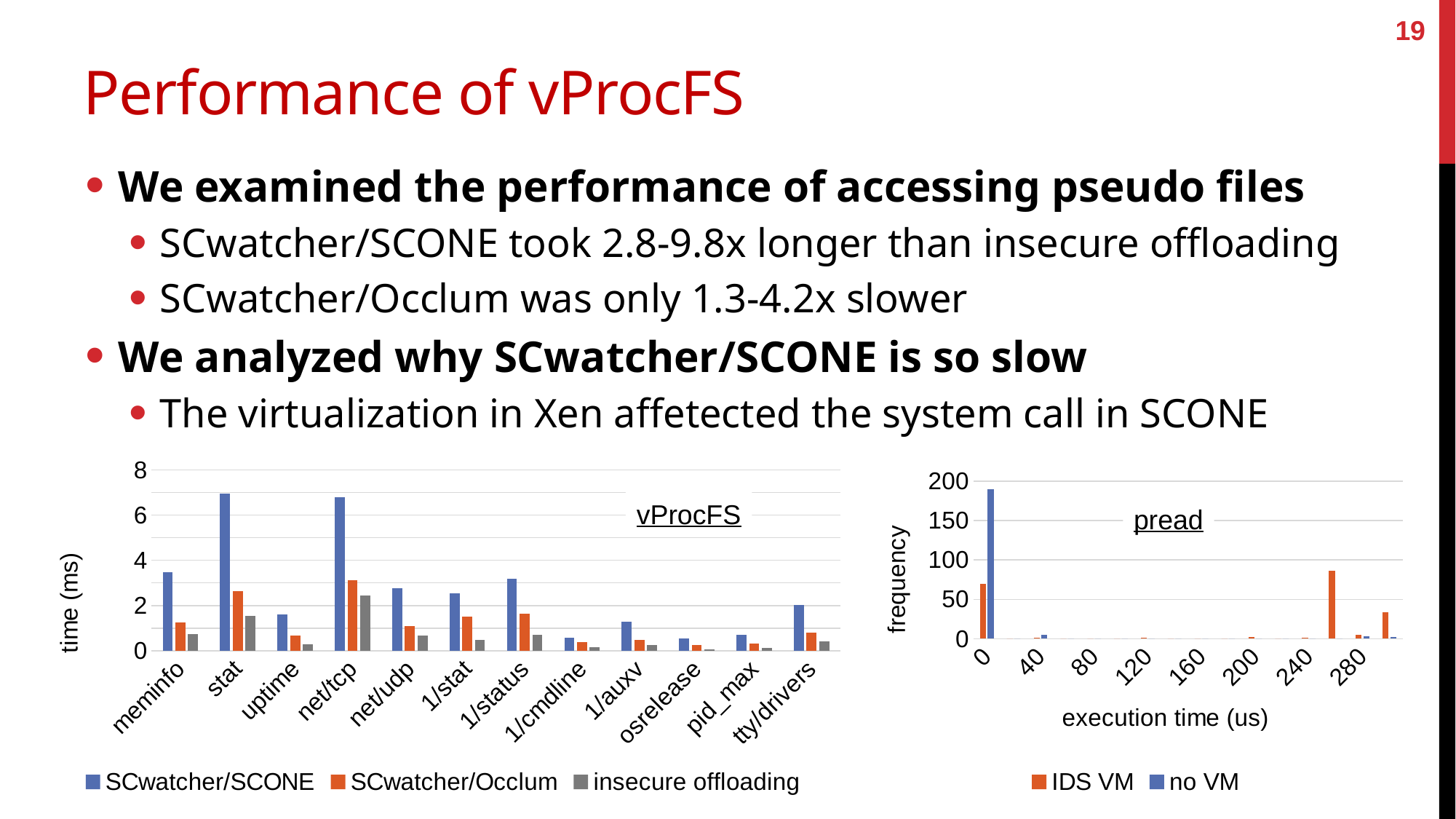
What kind of chart is the vProcFS chart? bar chart In the vProcFS chart, how many series does the legend list? 3 In the vProcFS chart, which category has the highest SCwatcher/Occlum value? net/tcp In the vProcFS chart, which category has the highest insecure offloading value? net/tcp What is the y-axis label of the pread chart? frequency In the vProcFS chart, is the SCwatcher/SCONE value for stat greater or less than 6? greater In the vProcFS chart, is the SCwatcher/SCONE value for uptime greater or less than 2? less In the pread chart, how many series does the legend list? 2 In the vProcFS chart, which is larger for stat: SCwatcher/SCONE or SCwatcher/Occlum? SCwatcher/SCONE In the pread chart, is the no VM frequency at execution time 0 greater or less than 150? greater In the vProcFS chart, how many categories are shown on the x axis? 12